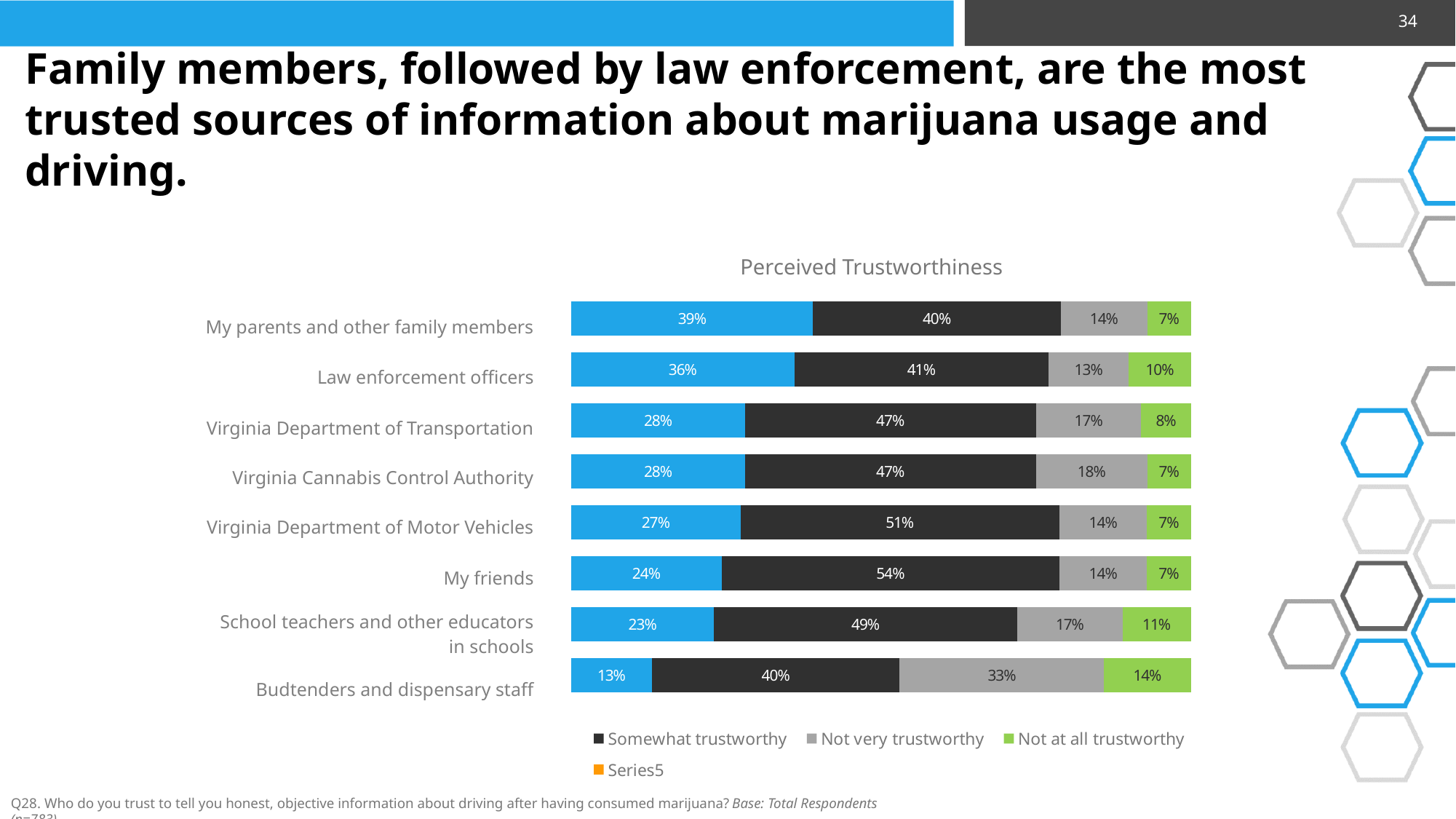
Which source has the highest 'Somewhat trustworthy' value? My friends What is the title of the chart? Perceived Trustworthiness What is the value of the leftmost blue segment for 'Law enforcement officers'? 36% How much higher is the 'Somewhat trustworthy' value for 'My friends' than for 'My parents and other family members'? 14 percentage points What is the 'Not very trustworthy' value for 'Budtenders and dispensary staff'? 33% How many information sources (categories) are plotted in the chart? 8 Which source has the highest 'Not at all trustworthy' value? Budtenders and dispensary staff What kind of chart is shown on the slide? Stacked bar chart Which has the larger 'Not very trustworthy' value: 'Virginia Department of Transportation' or 'Virginia Department of Motor Vehicles'? Virginia Department of Transportation How many entries does the chart legend list? 4 Which source has the lowest 'Not very trustworthy' value? Law enforcement officers What is the 'Somewhat trustworthy' value for 'My friends'? 54%